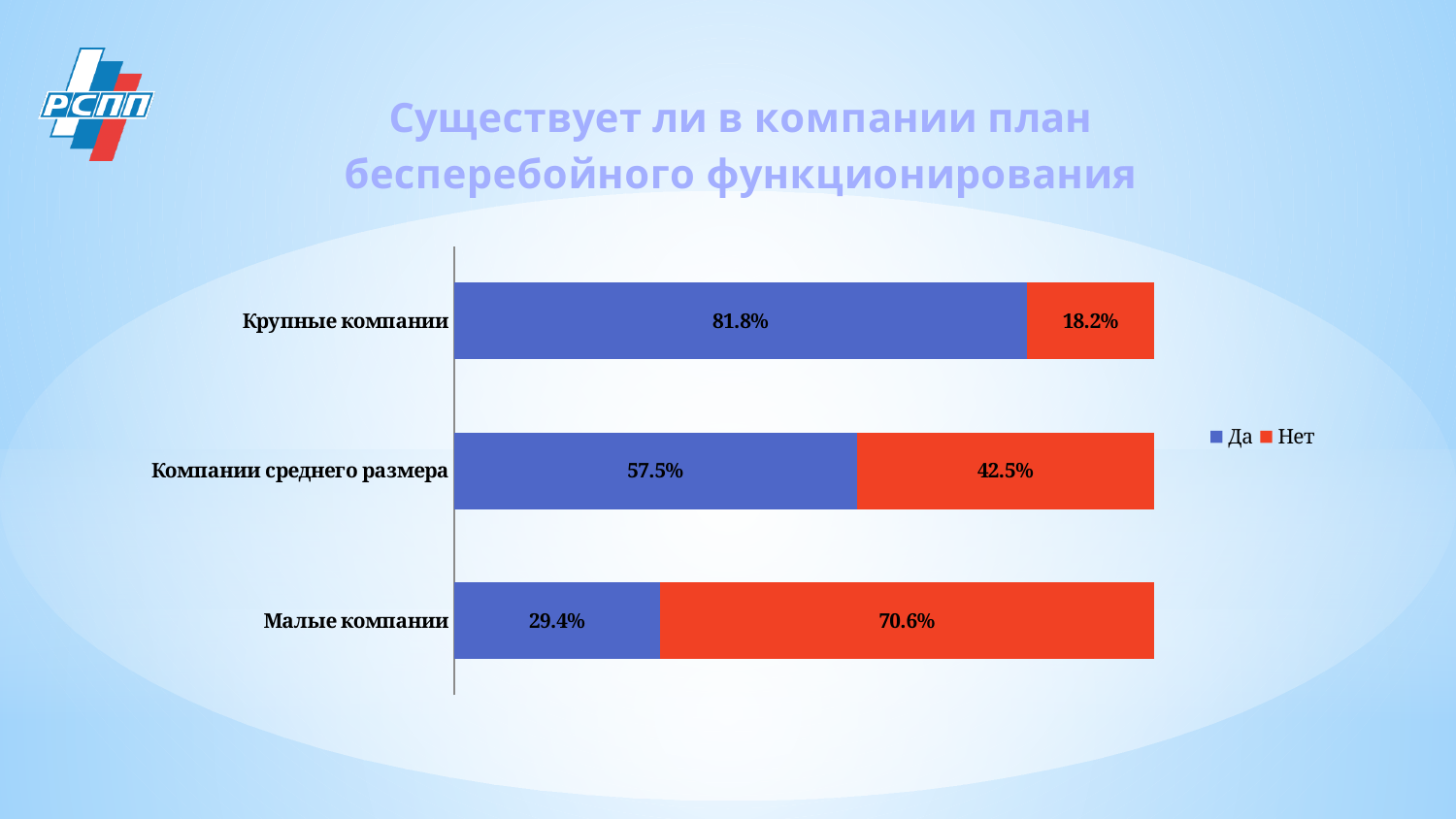
Which is larger for Малые компании: the "Да" value or the "Нет" value? Нет What is the total of the stacked bar for Компании среднего размера? 100% What kind of chart is shown on the slide? Stacked bar chart Which category has the lowest "Нет" value? Крупные компании What is the "Нет" value for Компании среднего размера? 42.5% How many categories are shown in the chart? 3 What is the "Нет" value for Малые компании? 70.6% What is the difference between the "Да" values for Крупные компании and Малые компании? 52.4% Which category has the highest "Да" value? Крупные компании What is the "Да" value for Крупные компании? 81.8% What is the "Да" value for Компании среднего размера? 57.5% How many series does the legend list? 2